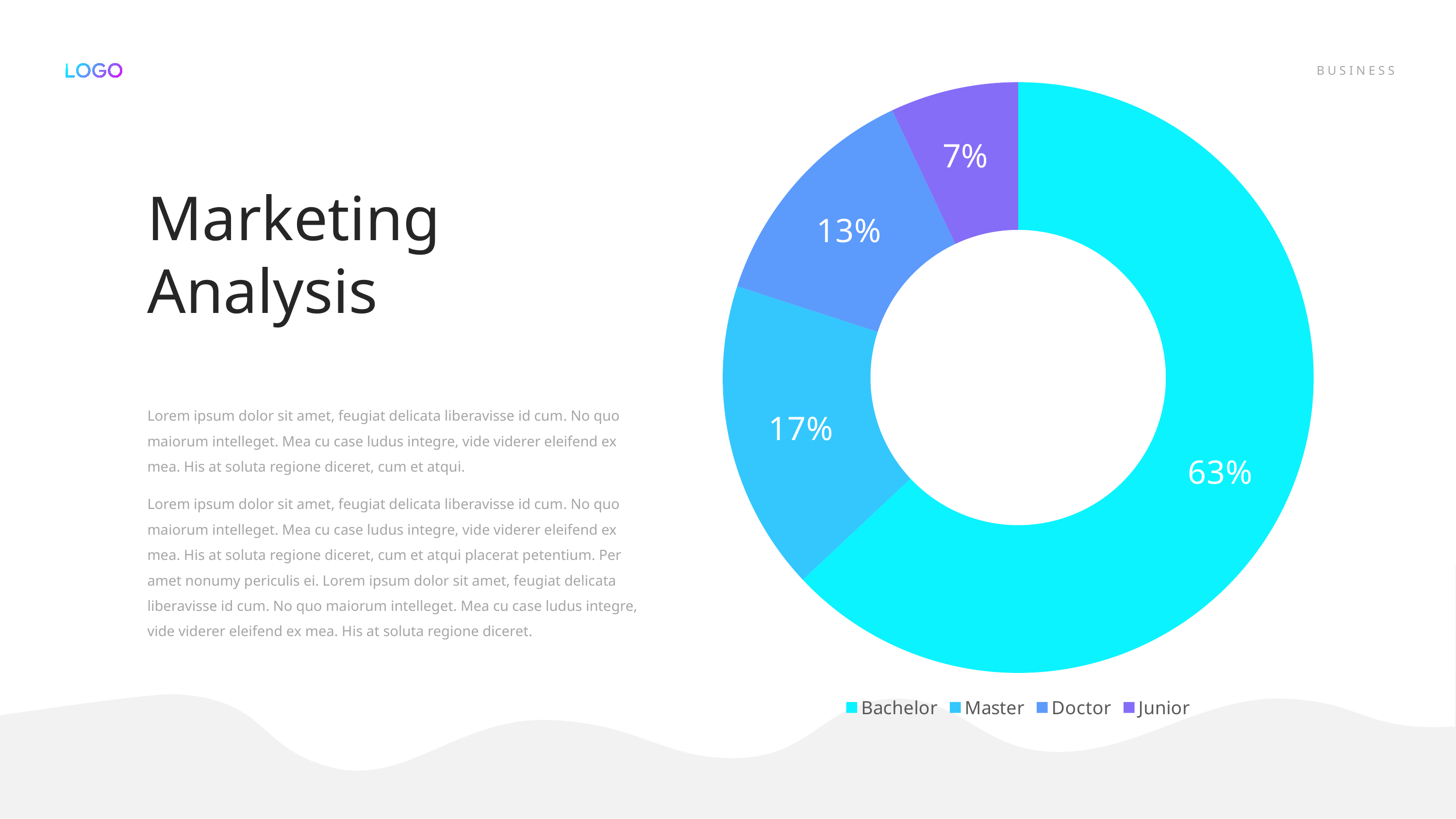
How many categories does the chart show? 4 What is the value shown for Junior? 7% What is the difference in percentage points between Bachelor and Master? 46 What is the value shown for Doctor? 13% What is the difference in percentage points between Doctor and Junior? 6 Which category is shown in purple in the legend? Junior Which category has the smallest share? Junior Which is larger, Master or Doctor? Master What share of the doughnut chart does Bachelor account for? 63% What is the value shown for Master? 17% What kind of chart is shown on the slide? Doughnut chart Which category has the largest share? Bachelor